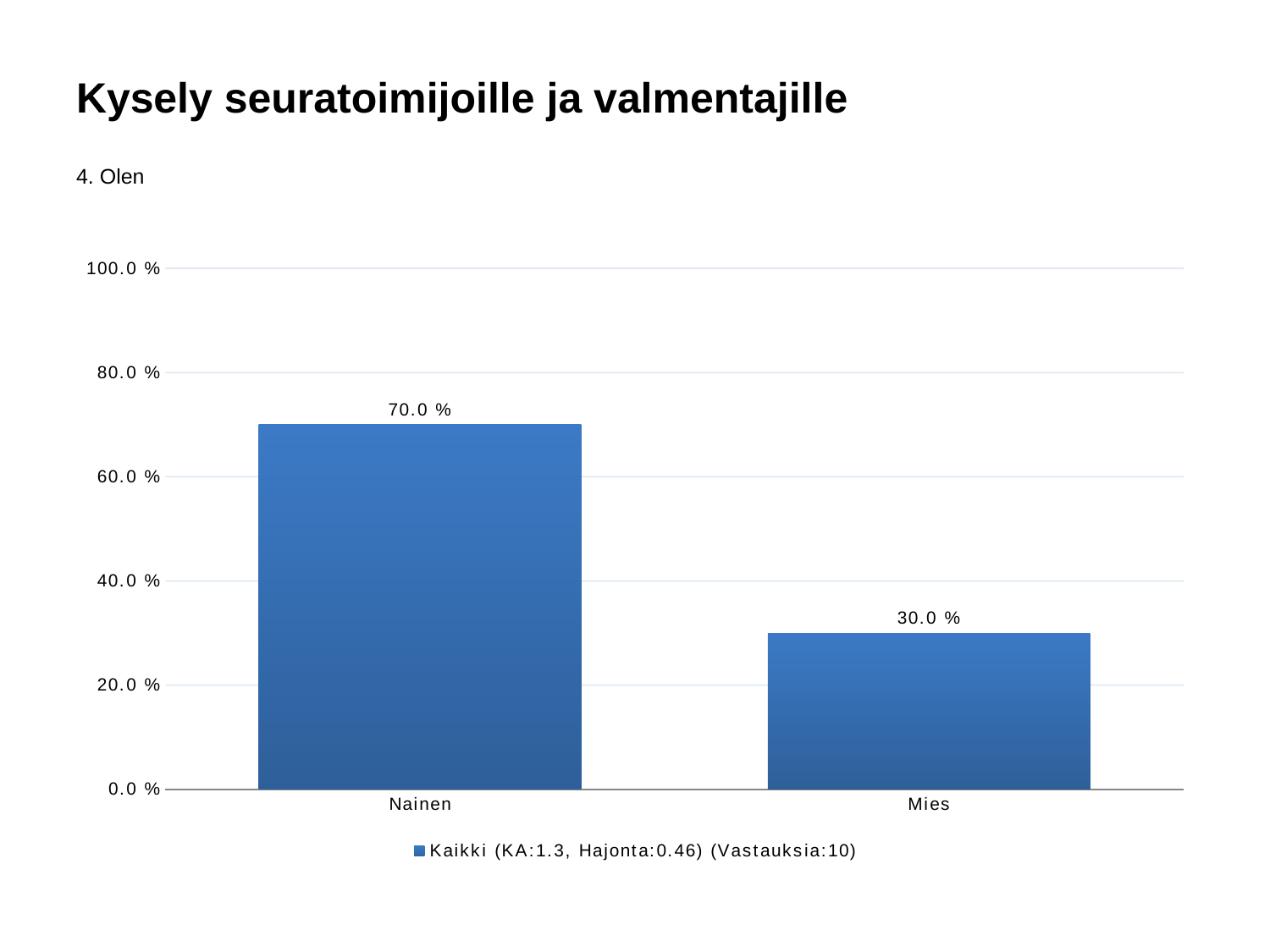
How many categories are shown on the x axis? 2 What is the value for Mies? 30.0 % What is the legend entry for the series shown? Kaikki (KA:1.3, Hajonta:0.46) (Vastauksia:10) Which is larger, the value for Nainen or the value for Mies? Nainen Which category has the lowest value? Mies What is the value for Nainen? 70.0 % What is the difference between the values for Nainen and Mies? 40.0 % Which category has the highest value? Nainen What kind of chart is shown on the slide? bar chart Is the value for Mies greater or less than 40.0 %? less Is the value for Nainen greater or less than 60.0 %? greater How many series does the legend list? 1